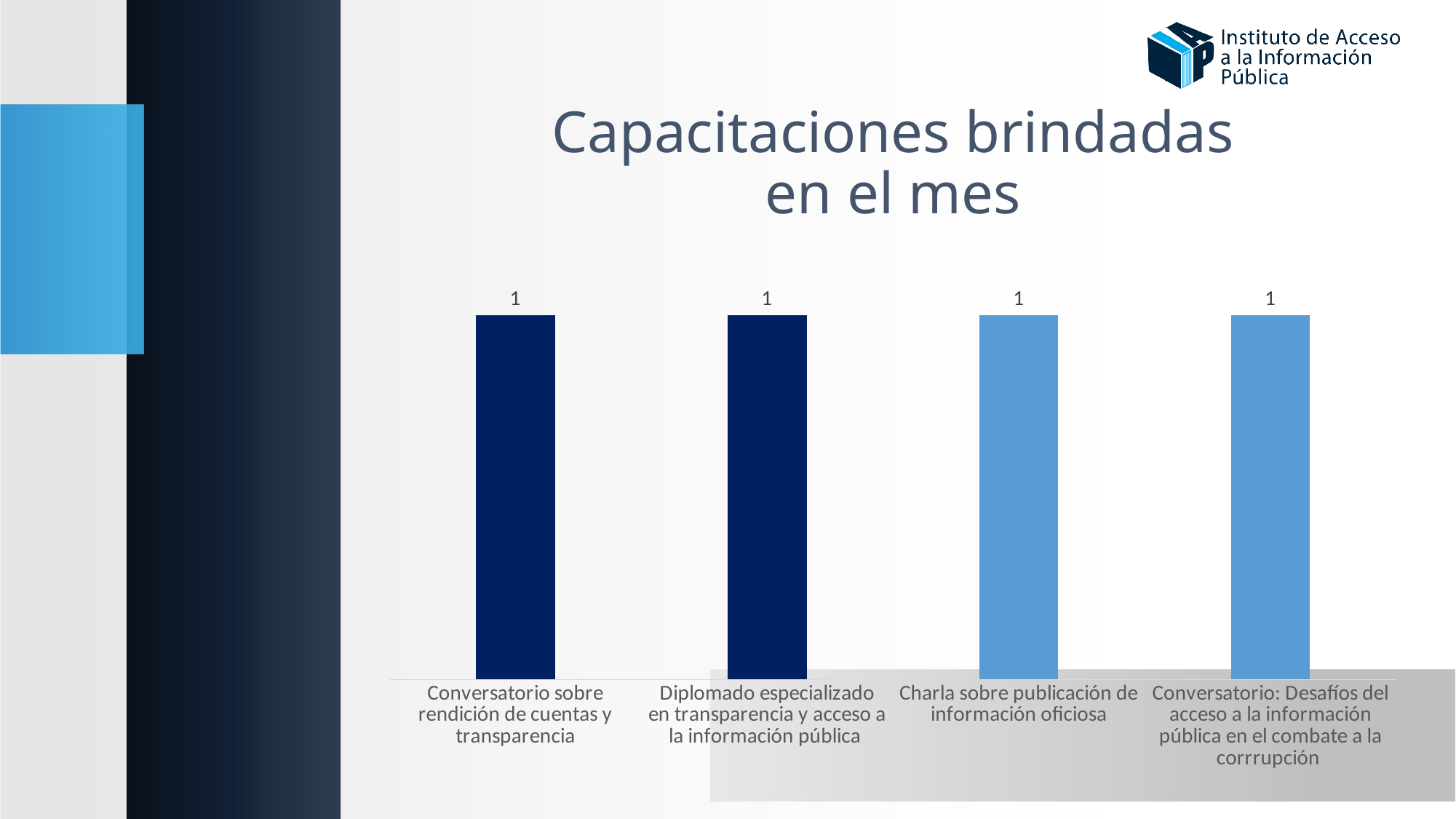
Do the values rise, fall, or stay the same across the categories from left to right? Stay the same What colour is the bar for "Charla sobre publicación de información oficiosa"? Light blue What is the value for "Conversatorio sobre rendición de cuentas y transparencia"? 1 What is the value for "Diplomado especializado en transparencia y acceso a la información pública"? 1 How many categories are shown in the chart? 4 What is the value for "Charla sobre publicación de información oficiosa"? 1 What is the value for "Conversatorio: Desafíos del acceso a la información pública en el combate a la corrrupción"? 1 What is the total of all the values shown in the chart? 4 What is the title of the chart? Capacitaciones brindadas en el mes What is the difference between the value for "Charla sobre publicación de información oficiosa" and the value for "Conversatorio sobre rendición de cuentas y transparencia"? 0 What kind of chart is shown on the slide? Bar chart